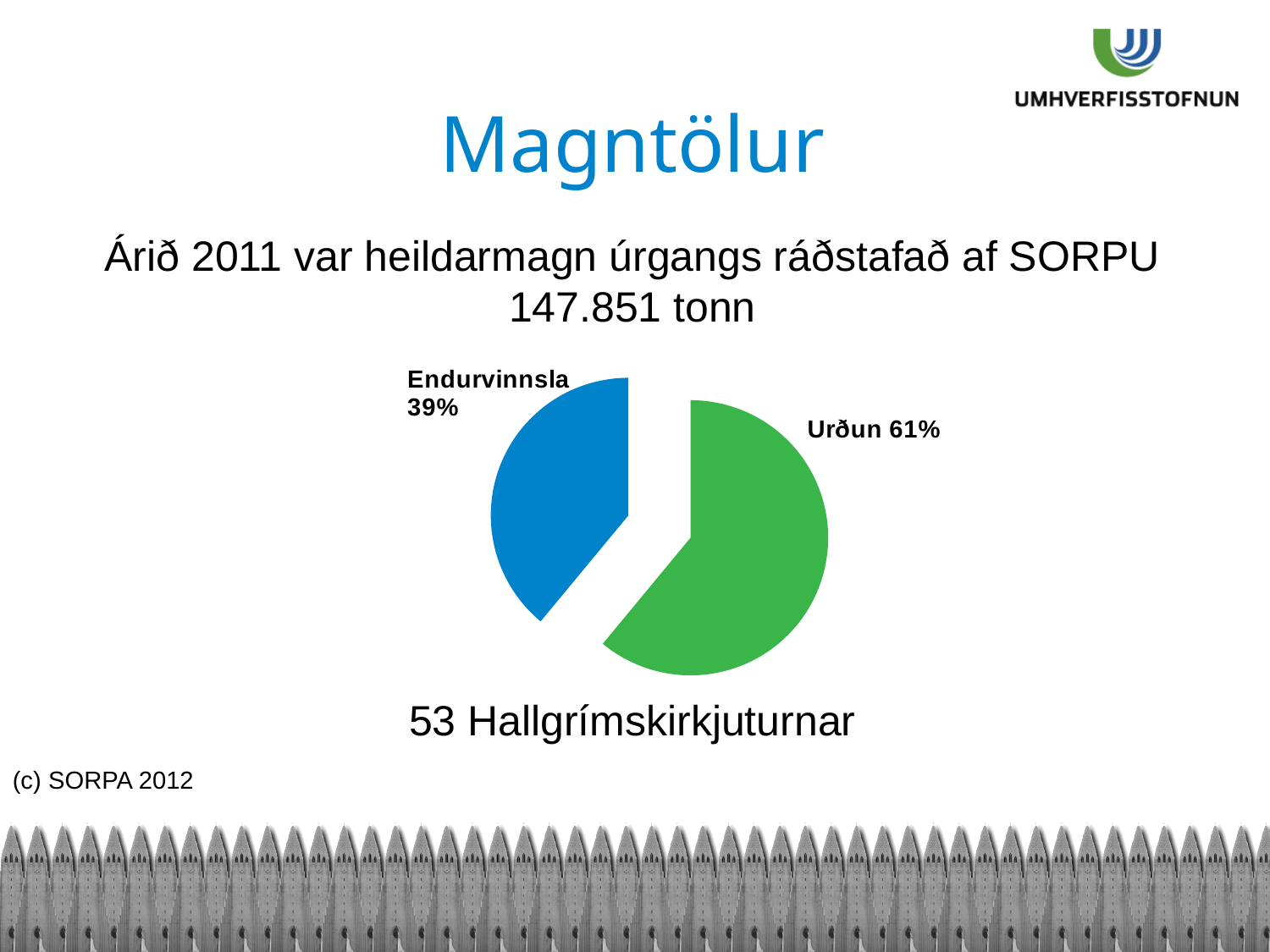
What kind of chart is shown on the slide? pie chart How many slices does the pie chart have? 2 What share of the pie does Endurvinnsla represent? 39% Which slice of the pie is the smallest? Endurvinnsla Which is larger, the Urðun slice or the Endurvinnsla slice? Urðun What share of the pie does Urðun represent? 61% Is the share for Urðun greater or less than 50%? greater What is the difference in percentage points between Urðun and Endurvinnsla? 22 What colour is the Endurvinnsla slice? blue Which slice of the pie is the largest? Urðun What colour is the Urðun slice? green Is the share for Endurvinnsla greater or less than 50%? less